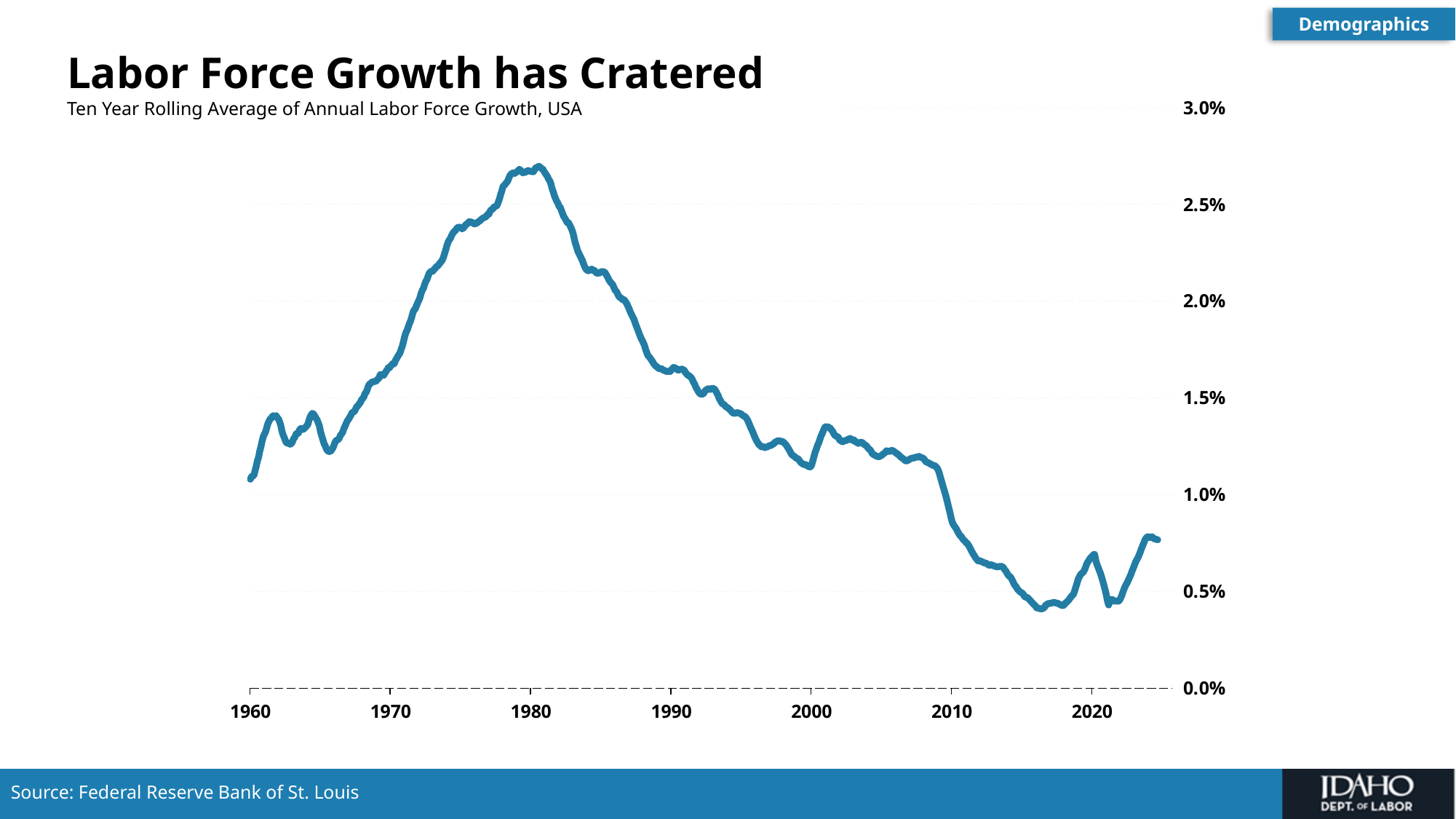
What kind of chart is shown on the slide? line chart Is the value of the line in 2000 greater or less than 1.0%? greater What is the title of the chart? Labor Force Growth has Cratered Does the line rise or fall between 1960 and 1980? rise What does the subtitle say the chart measures? Ten Year Rolling Average of Annual Labor Force Growth, USA Does the line rise or fall between 1980 and 2010? fall Is the value of the line in 1960 greater or less than 1.5%? less Is the value of the line around 1980 greater or less than 2.5%? greater Which is larger, the value of the line in 1980 or in 2020? 1980 Near which labeled year on the x axis does the line reach its highest point? 1980